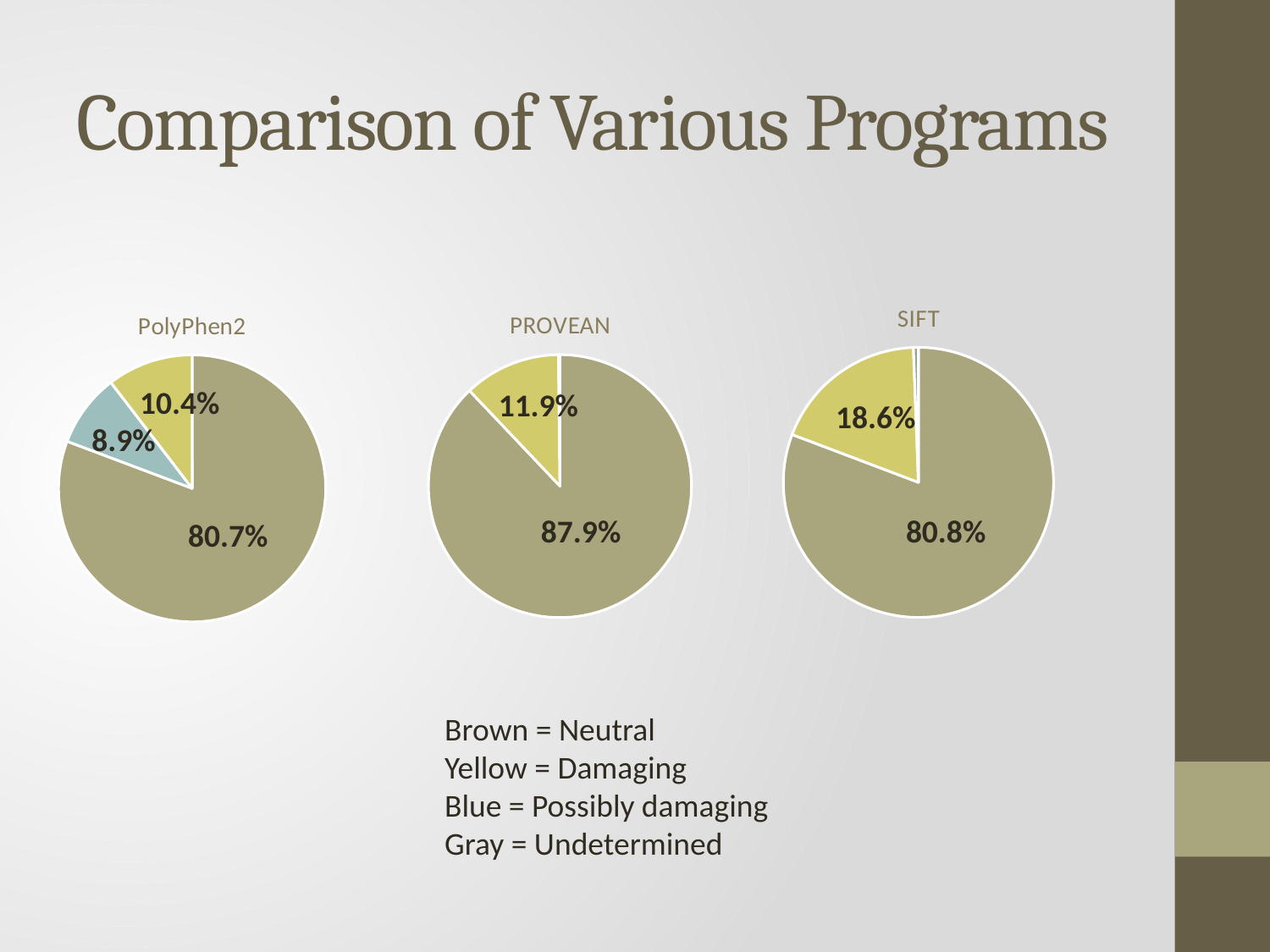
In the PROVEAN pie chart, what percentage is labelled on the yellow (Damaging) slice? 11.9% In the SIFT pie chart, what percentage is labelled on the brown (Neutral) slice? 80.8% Which of the three pie charts has the largest Damaging (yellow) share? SIFT What type of chart is used for PolyPhen2, PROVEAN and SIFT on this slide? Pie chart In the PolyPhen2 pie chart, what percentage is labelled on the blue (Possibly damaging) slice? 8.9% In the PolyPhen2 pie chart, what percentage is labelled on the yellow (Damaging) slice? 10.4% According to the colour key on the slide, what does the yellow colour represent? Damaging Which of the three pie charts has the largest Neutral (brown) share? PROVEAN In the PolyPhen2 pie chart, which slice is larger: the yellow (Damaging) slice or the blue (Possibly damaging) slice? Yellow (Damaging) In the SIFT pie chart, what percentage is labelled on the yellow (Damaging) slice? 18.6% What is the difference between the Damaging share in the SIFT chart and the Damaging share in the PROVEAN chart? 6.7% In the PolyPhen2 pie chart, what percentage is labelled on the brown (Neutral) slice? 80.7%